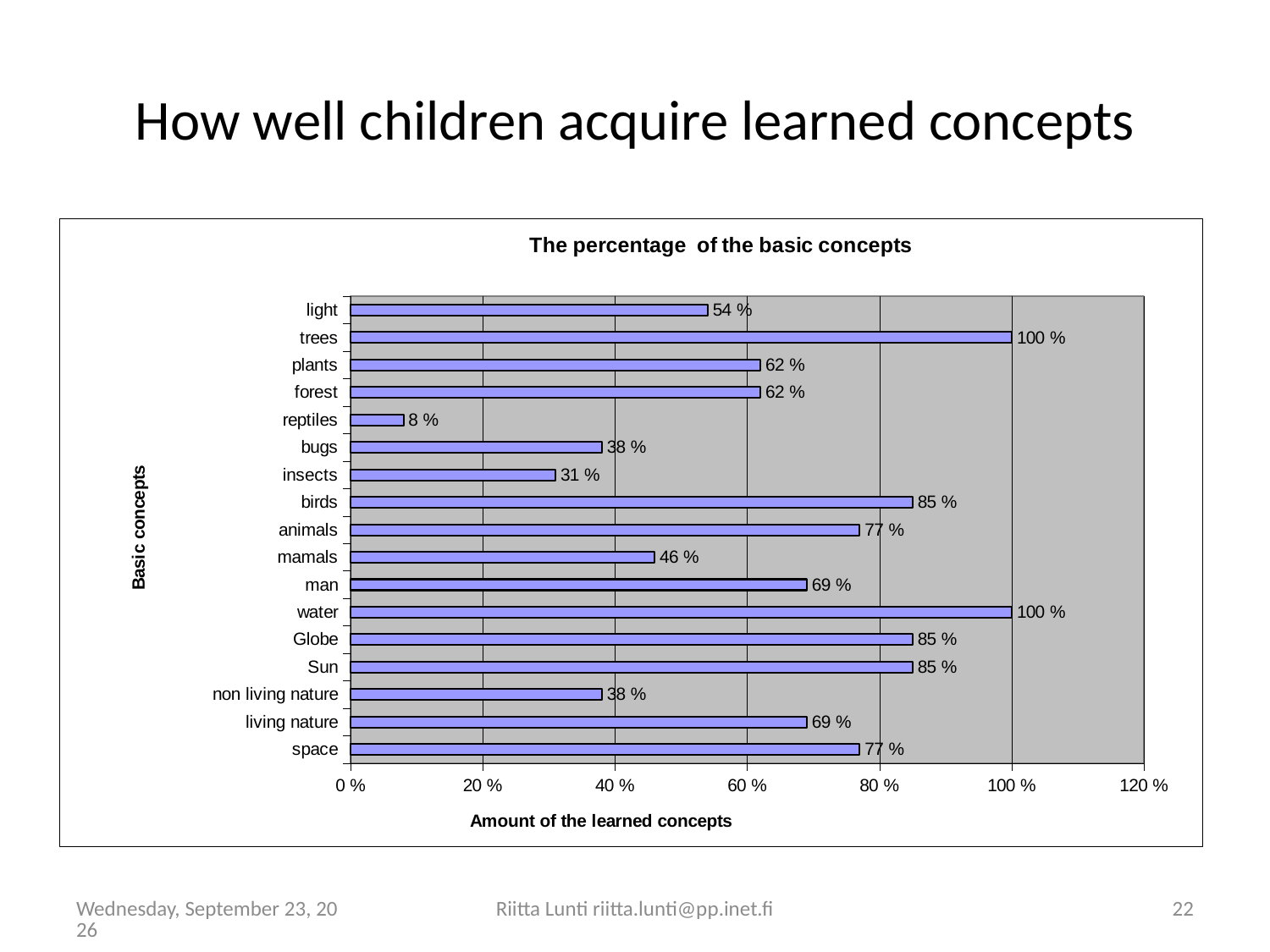
What is the value for mamals? 46 % What is the title of the chart? The percentage of the basic concepts What kind of chart is shown on the slide? bar chart What is the difference between the values for trees and light? 46 % What is the value for non living nature? 38 % What is the value for birds? 85 % Which is larger, the value for man or the value for bugs? man How many categories are shown on the chart? 17 What is the value for reptiles? 8 % What is the difference between the values for animals and insects? 46 % Which category has the lowest value? reptiles Is the value for space greater or less than 60 %? greater